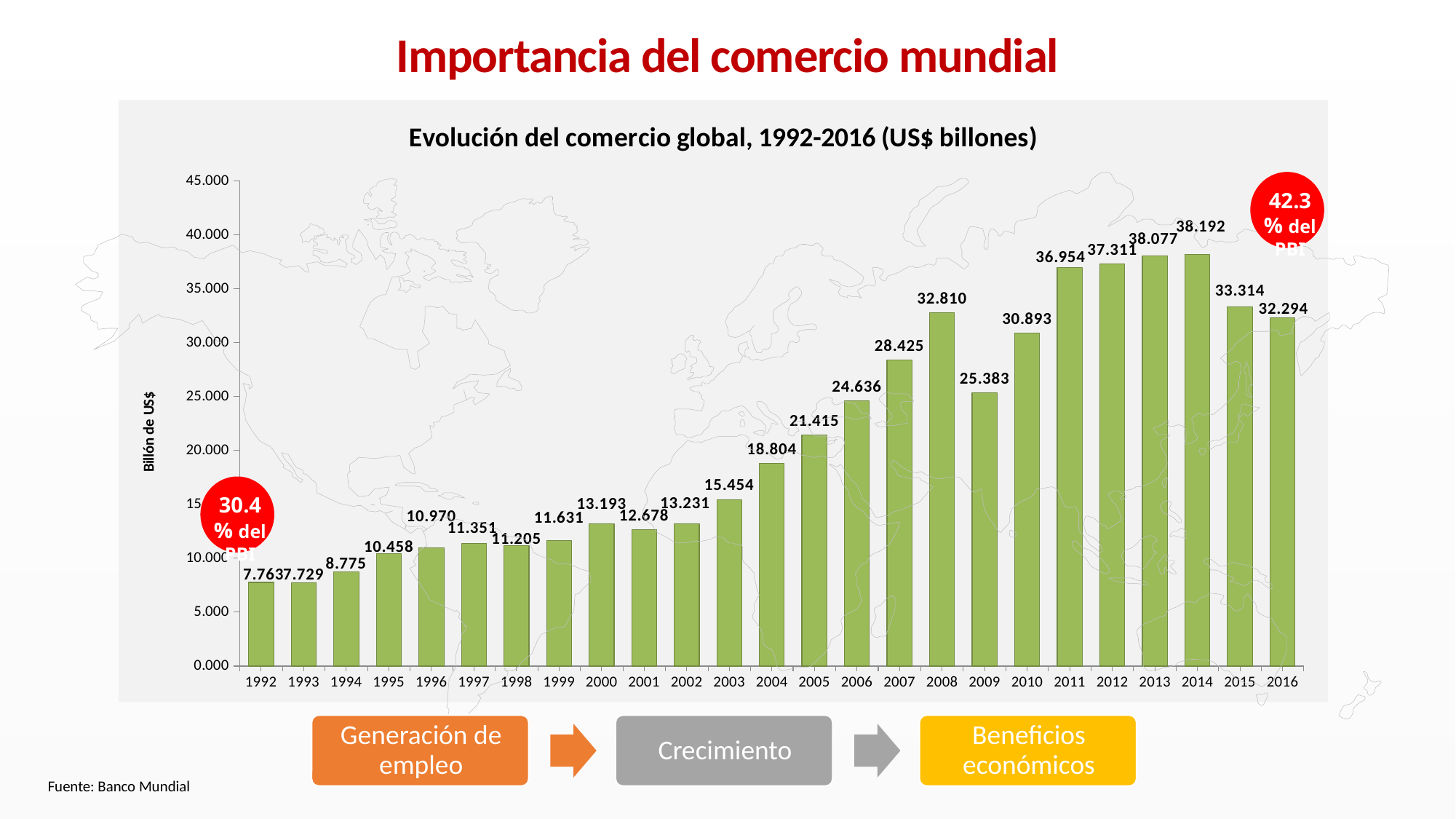
What kind of chart is shown on the slide? Bar chart Is the value for 2010 greater or less than 30.000? greater What is the value for 2016 in the chart? 32.294 Do the values generally rise or fall from 1992 to 2014? Rise Which year has the lowest value in the chart? 1993 What is the value for 2008 in the chart? 32.810 Which is larger, the value for 2000 or the value for 2001? 2000 What is the value for 1992 in the chart? 7.763 How many years are shown on the x axis of the chart? 25 What is the title of the chart? Evolución del comercio global, 1992-2016 (US$ billones) Which year has the highest value in the chart? 2014 What is the difference between the values for 2008 and 2009? 7.427